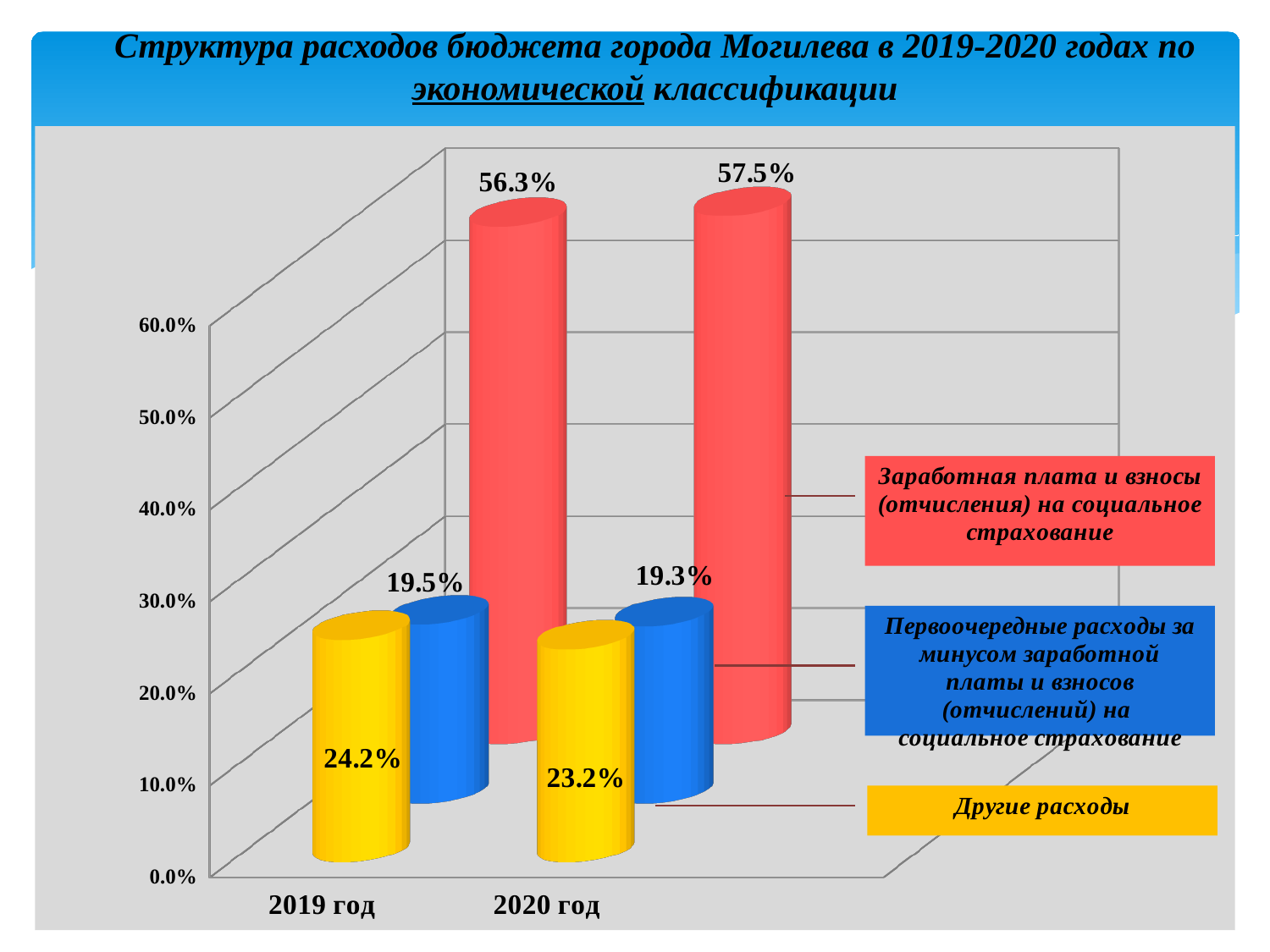
How many series does the legend list? 3 How many year categories are shown on the x axis? 2 What is the value for "Другие расходы" in 2020 год? 23.2% Which is larger: "Другие расходы" in 2019 год or in 2020 год? 2019 год Which series has the lowest value in 2020 год? Первоочередные расходы за минусом заработной платы и взносов (отчислений) на социальное страхование What is the value for "Заработная плата и взносы (отчисления) на социальное страхование" in 2019 год? 56.3% Which series has the highest value in 2019 год? Заработная плата и взносы (отчисления) на социальное страхование What is the value for "Первоочередные расходы за минусом заработной платы и взносов (отчислений) на социальное страхование" in 2020 год? 19.3% What kind of chart is shown on the slide? Bar chart What is the difference between the "Заработная плата и взносы (отчисления) на социальное страхование" values for 2020 год and 2019 год? 1.2% What is the value for "Другие расходы" in 2019 год? 24.2% What is the value for "Заработная плата и взносы (отчисления) на социальное страхование" in 2020 год? 57.5%